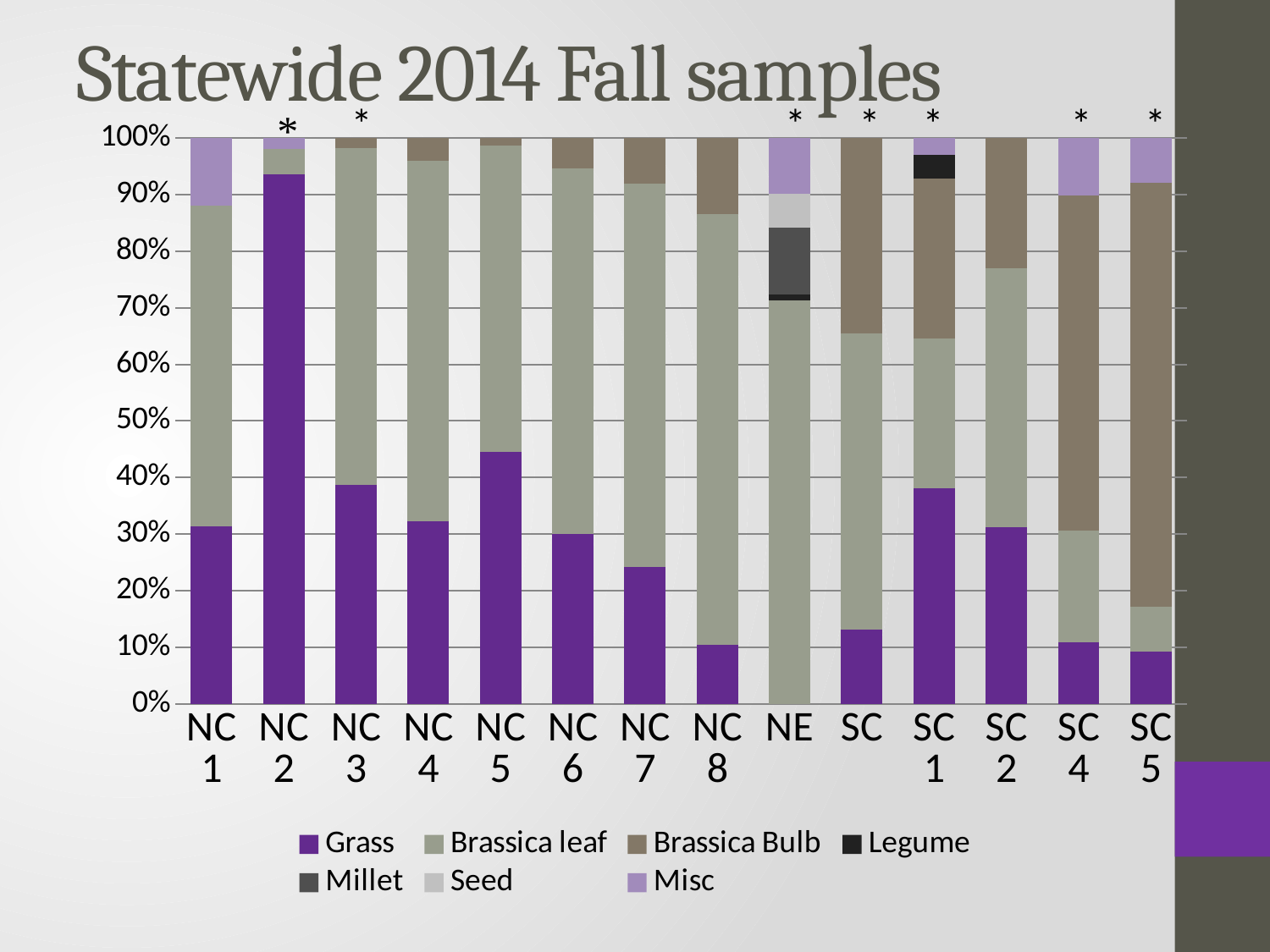
Which category has the highest Grass share? NC 2 What does each stacked bar total on the y axis? 100% How many series does the legend list? 7 Which has the larger Grass share, SC 1 or SC? SC 1 What kind of chart is shown on the slide? Stacked bar chart How many categories (bars) are shown along the x axis? 14 Is the Grass share for NC 8 greater or less than 20%? less Is the Grass share for NC 5 greater or less than 40%? greater What is the title of the chart? Statewide 2014 Fall samples Which series is shown in dark purple at the bottom of each bar? Grass Which has the larger Grass share, NC 1 or NC 2? NC 2 Is the Grass share for NC 2 greater or less than 90%? greater